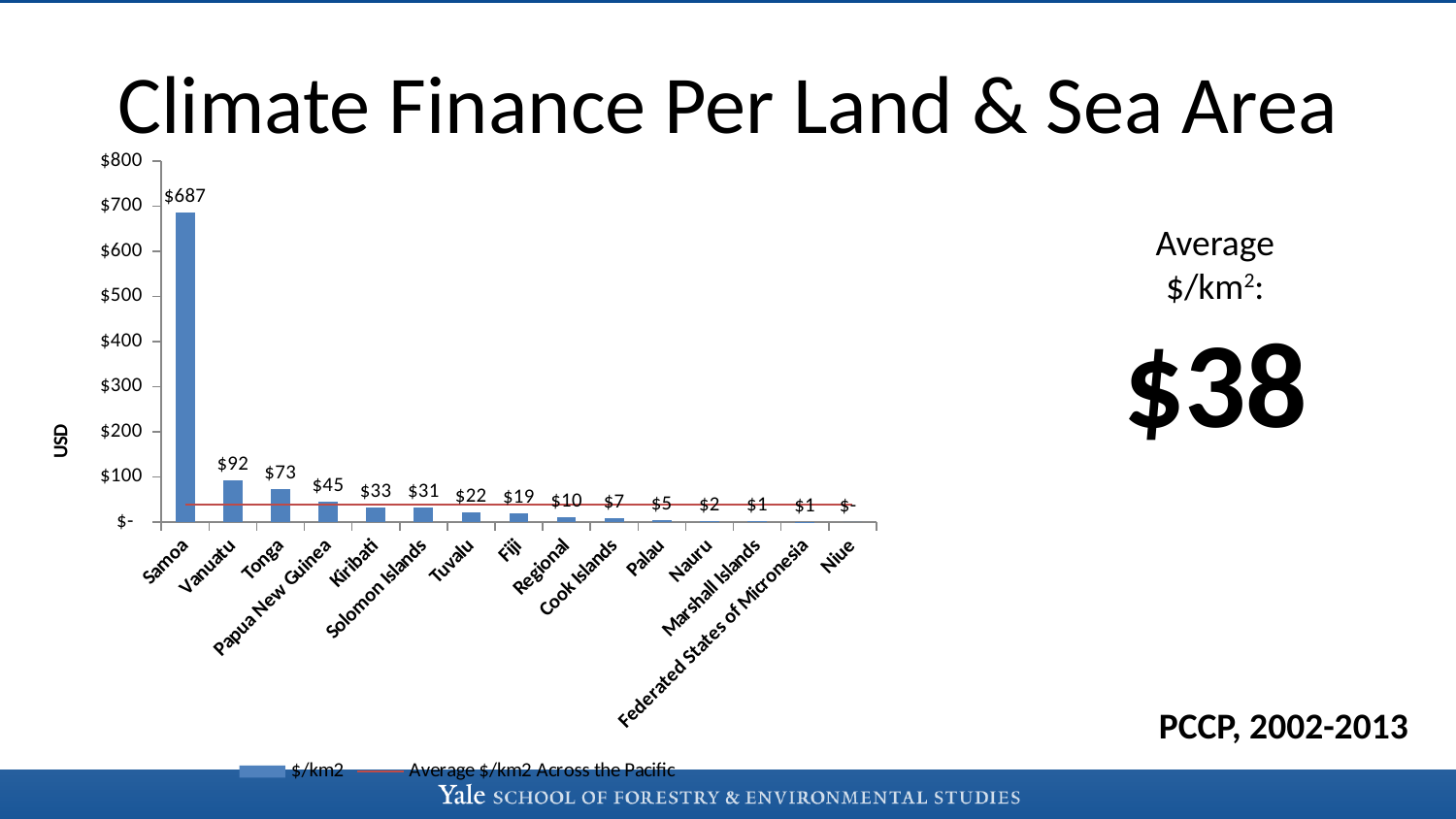
What is the value for Tuvalu? $22 Which category has the lowest value? Niue Is the value for Samoa greater or less than $600? greater What kind of chart is shown on the slide? Bar chart How many series does the legend list? 2 What is the value for Papua New Guinea? $45 Which category has the highest value? Samoa What is the value for Samoa? $687 How many categories are shown on the x axis? 15 What is the difference between the values for Vanuatu and Tonga? $19 Which is larger, the value for Kiribati or the value for Fiji? Kiribati What is the average $/km2 across the Pacific shown on the slide? $38